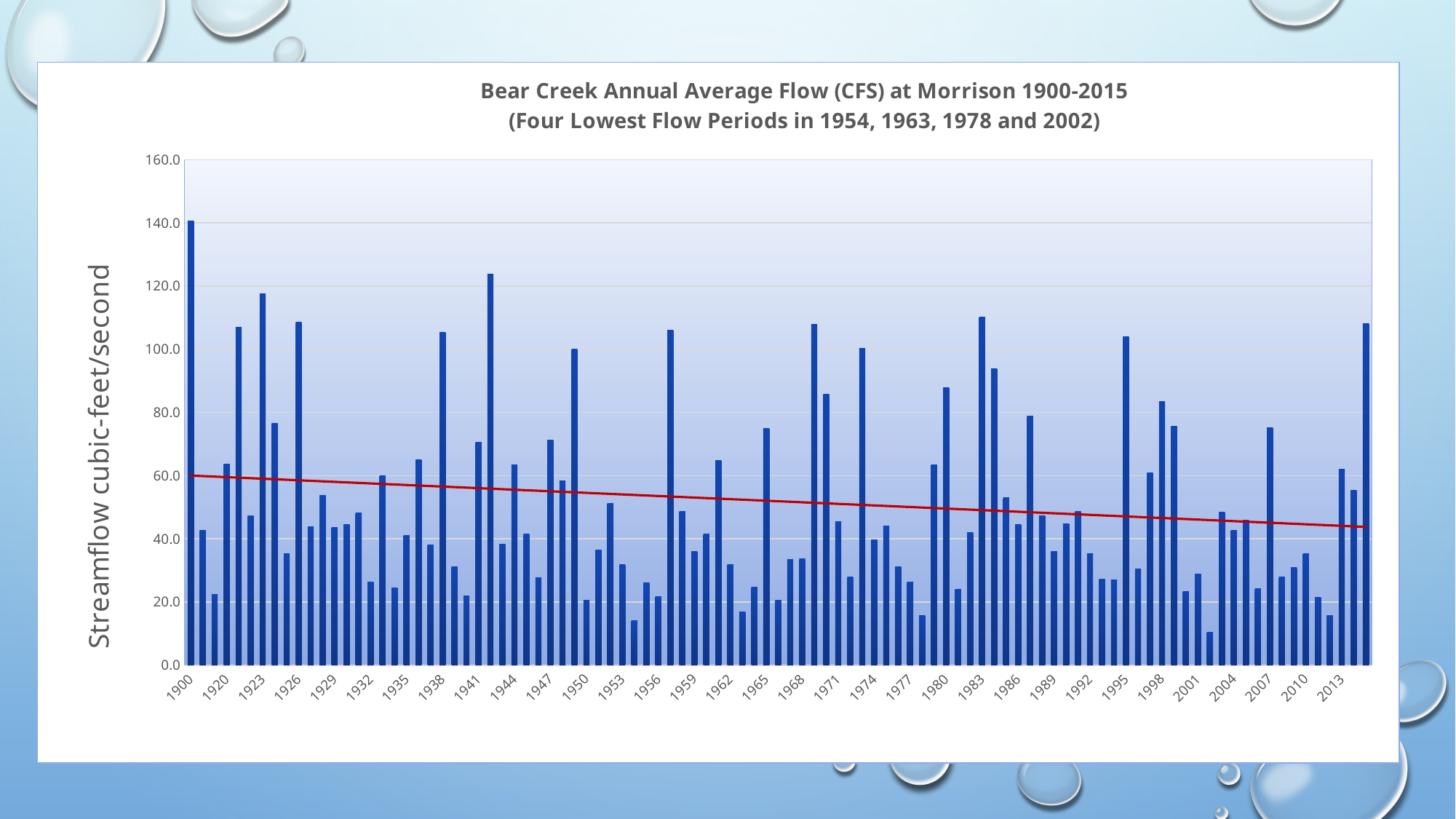
Is the value for 1900 greater or less than 120? greater What is the label on the vertical axis? Streamflow cubic-feet/second Is the value for 1900 greater or less than 160? less Which year has the highest annual average flow? 1900 Does the red trend line rise or fall from 1900 to 2015? fall What is the title of the chart? Bear Creek Annual Average Flow (CFS) at Morrison 1900-2015 (Four Lowest Flow Periods in 1954, 1963, 1978 and 2002) What kind of chart is shown on the slide? bar chart